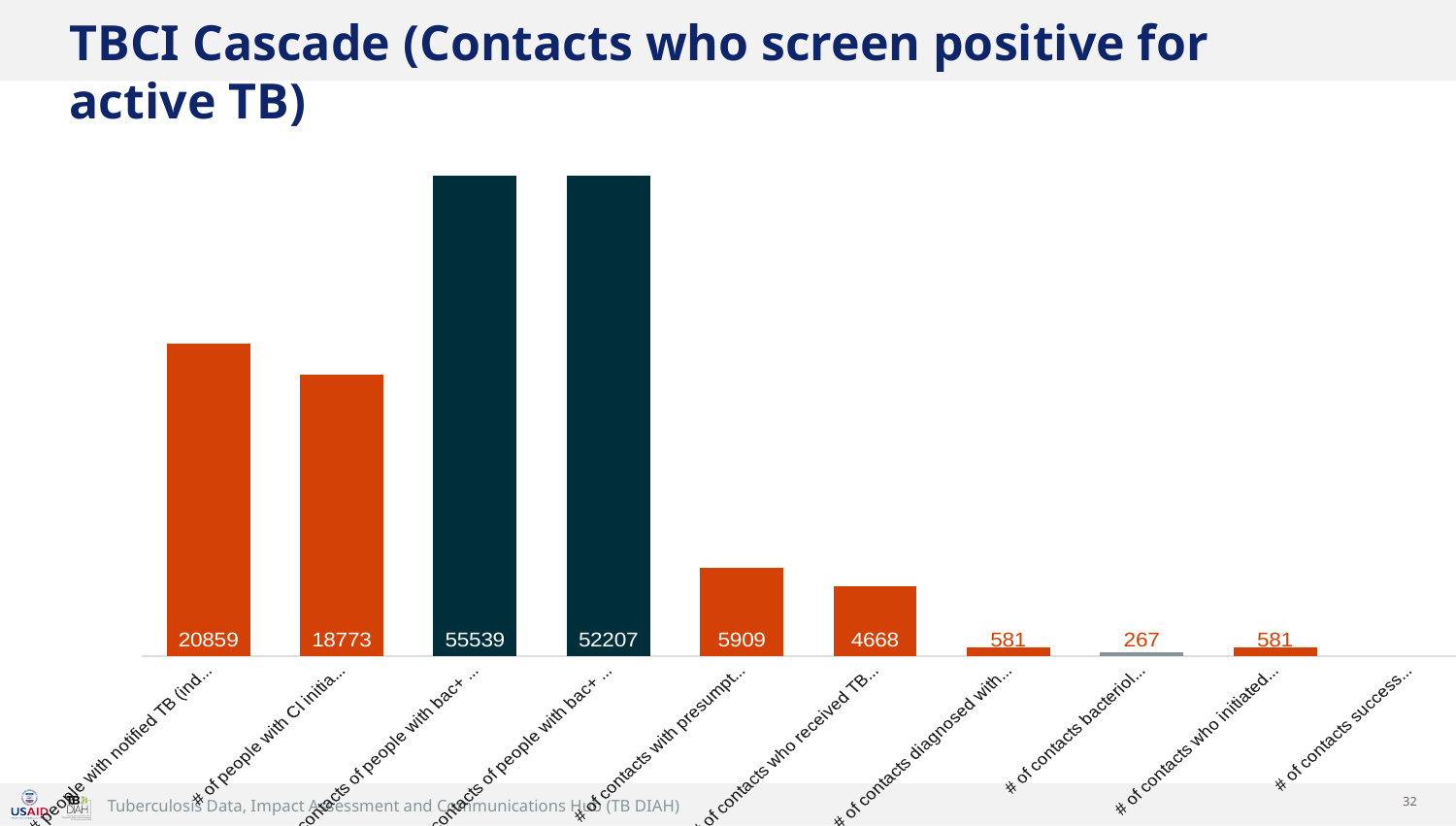
What kind of chart is shown on the slide? bar chart What is the value of the bar labelled "# of contacts bacteriol..."? 267 What is the value of the bar labelled "# of people with CI initia..."? 18773 What is the difference between the values for "# of people with notified TB (ind..." and "# of people with CI initia..."? 2086 What is the value of the bar labelled "# of contacts with presumpt..."? 5909 What is the value of the bar labelled "# of contacts who received TB..."? 4668 How many categories are shown along the x axis of the chart? 10 What is the value of the first bar, labelled "# of people with notified TB (ind..."? 20859 What is the difference between the third bar (55539) and the fourth bar (52207)? 3332 Which is larger: the value for "# of contacts with presumpt..." or the value for "# of contacts who received TB..."? # of contacts with presumpt... Which bar has the highest value in the chart? the third bar (# of contacts of people with bac+ ...), 55539 What is the value of the bar labelled "# of contacts who initiated..."? 581